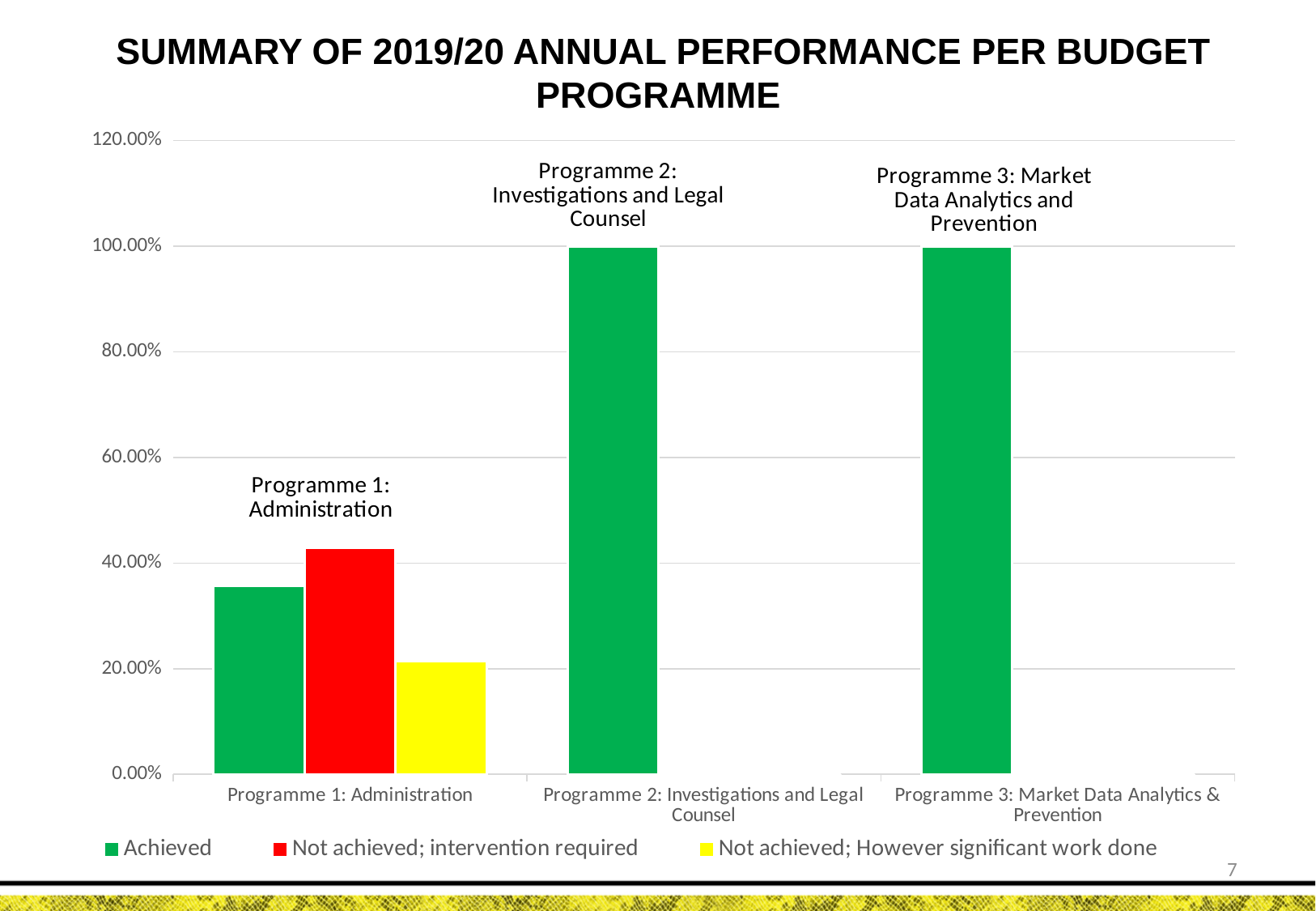
Is the 'Not achieved; intervention required' value for Programme 1: Administration greater or less than 40.00%? greater What is the Achieved value for Programme 3: Market Data Analytics & Prevention? 100.00% How many series does the legend list? 3 Is the Achieved value for Programme 1: Administration greater or less than 40.00%? less Which series has the lowest value for Programme 1: Administration? Not achieved; However significant work done What kind of chart is shown on the slide? Bar chart Which series has the highest value for Programme 1: Administration? Not achieved; intervention required What is the Achieved value for Programme 2: Investigations and Legal Counsel? 100.00% For Programme 1: Administration, which is larger: Achieved or 'Not achieved; intervention required'? Not achieved; intervention required What colour represents the 'Achieved' series in the chart? Green Is the 'Not achieved; However significant work done' value for Programme 1: Administration greater or less than 40.00%? less How many budget programmes are shown on the x axis? 3